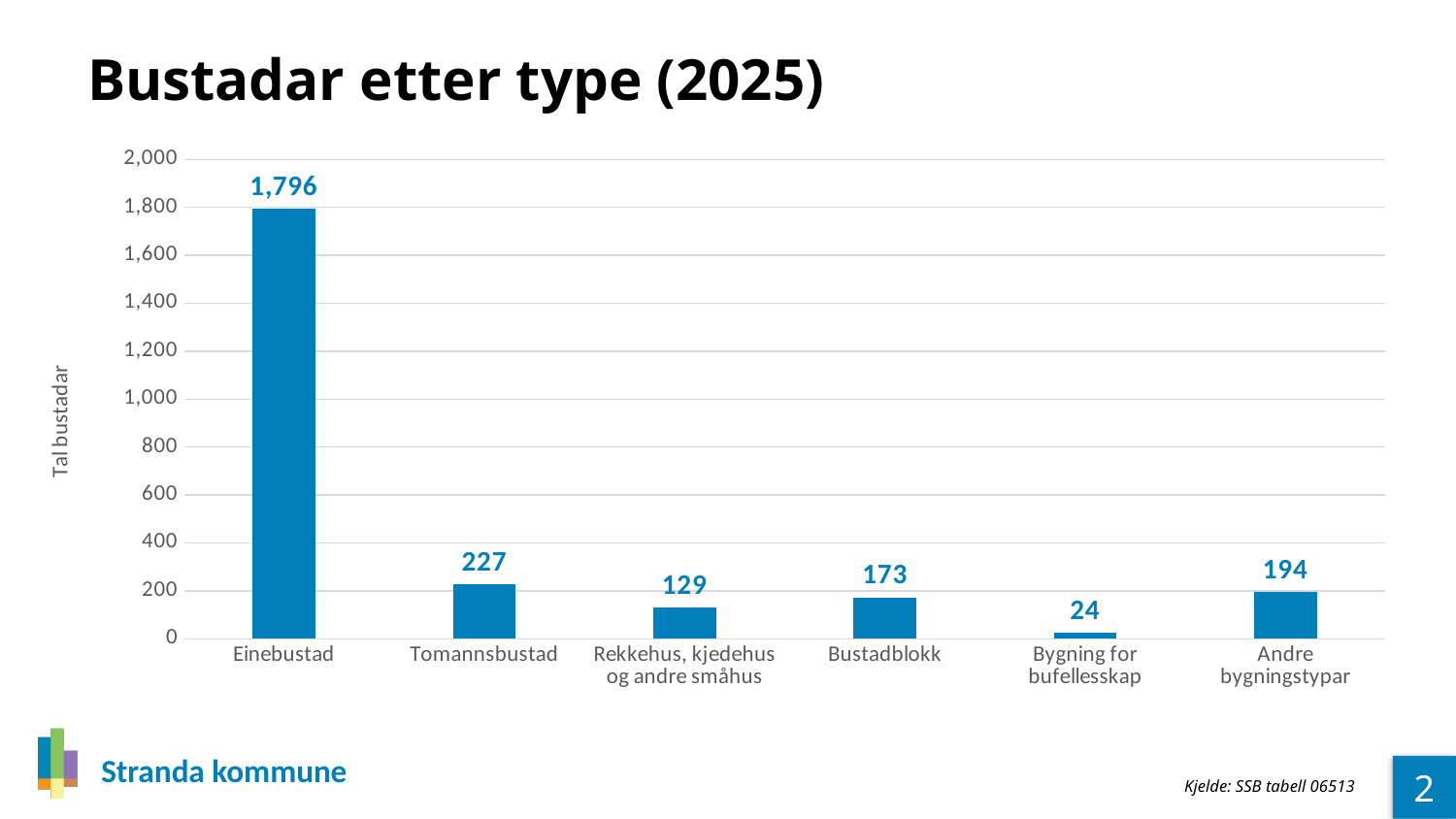
What kind of chart is shown on the slide? bar chart What is the value for Einebustad? 1,796 Which category has the lowest value? Bygning for bufellesskap What is the value for Andre bygningstypar? 194 What is the value for Tomannsbustad? 227 What is the value for Bygning for bufellesskap? 24 How many categories are shown on the x axis? 6 Which category has the highest value? Einebustad Is the value for Bustadblokk greater or less than 200? less Which is larger, the value for Rekkehus, kjedehus og andre småhus or the value for Andre bygningstypar? Andre bygningstypar What is the difference between the values for Tomannsbustad and Bustadblokk? 54 What is the title of the chart? Bustadar etter type (2025)